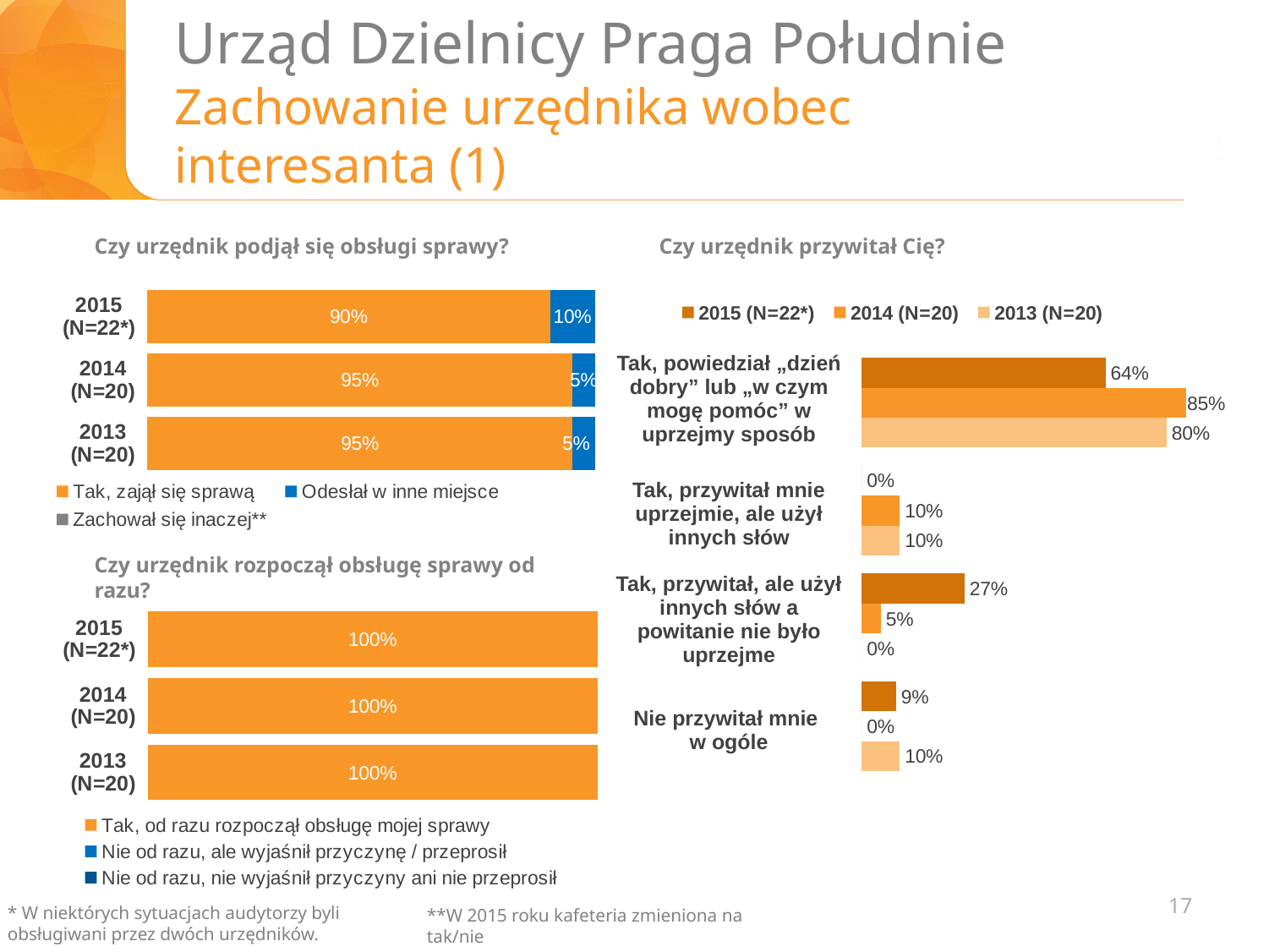
In the chart "Czy urzędnik rozpoczął obsługę sprawy od razu?", how many years are shown? 3 In the chart "Czy urzędnik podjął się obsługi sprawy?", what is the difference between the "Tak, zajął się sprawą" values for 2014 (N=20) and 2015 (N=22*)? 5% In the chart "Czy urzędnik podjął się obsługi sprawy?", which year has the lowest share of "Tak, zajął się sprawą"? 2015 (N=22*) In the chart "Czy urzędnik podjął się obsługi sprawy?", what percentage for 2015 (N=22*) is "Odesłał w inne miejsce"? 10% In the chart "Czy urzędnik przywitał Cię?", which year has the highest value for "Tak, powiedział „dzień dobry” lub „w czym mogę pomóc” w uprzejmy sposób"? 2014 (N=20) In the chart "Czy urzędnik przywitał Cię?", what is the 2015 (N=22*) value for "Tak, przywitał, ale użył innych słów a powitanie nie było uprzejme"? 27% What type of chart is "Czy urzędnik przywitał Cię?"? Bar chart In the chart "Czy urzędnik przywitał Cię?", what is the 2014 (N=20) value for "Tak, powiedział „dzień dobry” lub „w czym mogę pomóc” w uprzejmy sposób"? 85% In the chart "Czy urzędnik podjął się obsługi sprawy?", how many series does the legend list? 3 In the chart "Czy urzędnik podjął się obsługi sprawy?", what percentage for 2015 (N=22*) is "Tak, zajął się sprawą"? 90% In the chart "Czy urzędnik rozpoczął obsługę sprawy od razu?", what is the value for 2013 (N=20)? 100% In the chart "Czy urzędnik przywitał Cię?", what is the difference between the 2014 (N=20) and 2015 (N=22*) values for "Tak, powiedział „dzień dobry” lub „w czym mogę pomóc” w uprzejmy sposób"? 21%